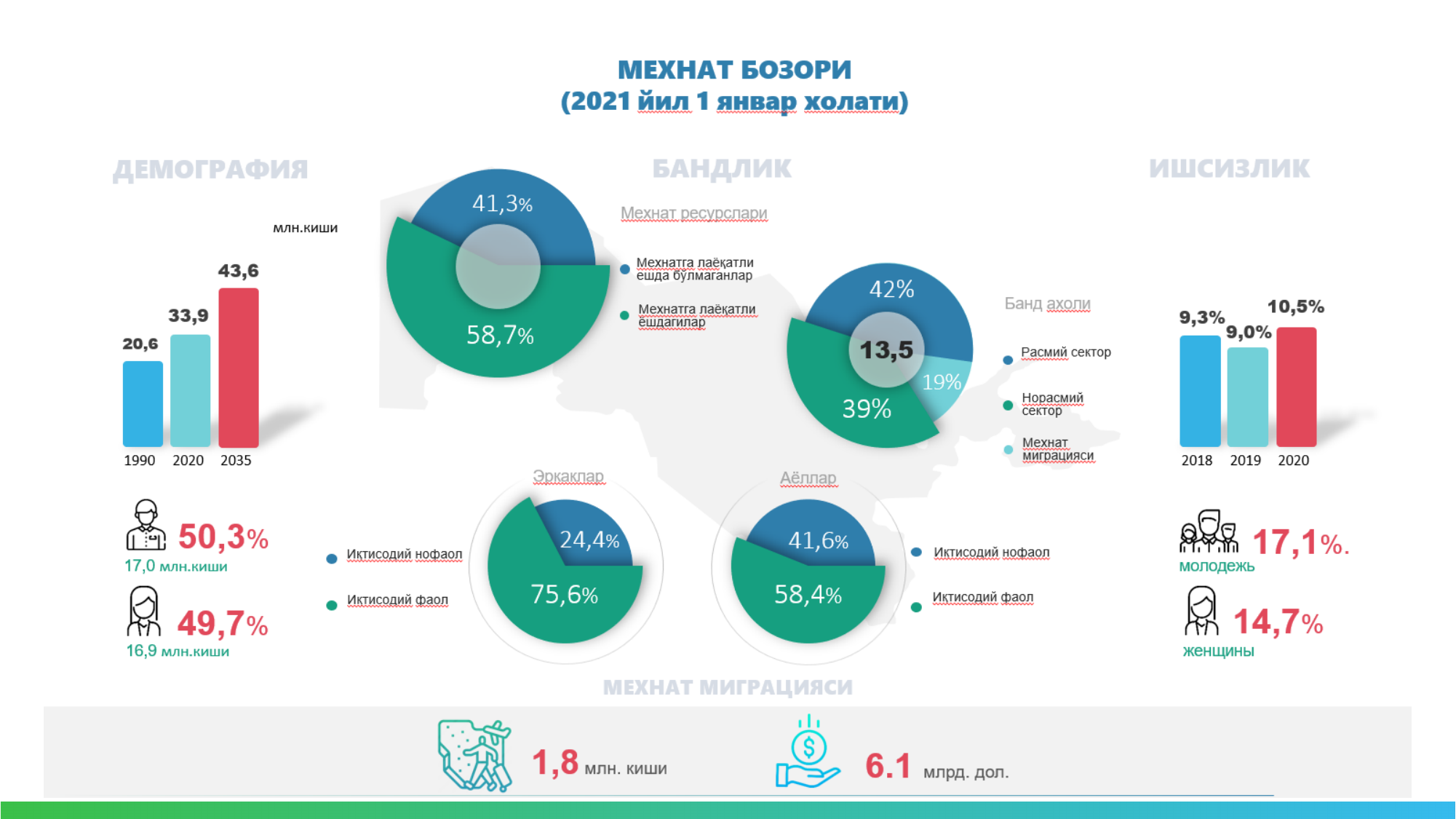
In the pie chart titled Мехнат ресурслари, what share is labelled Мехнатга лаёқатли ёшдагилар? 58,7% In the pie chart titled Аёллар, which slice is larger, Иқтисодий фаол or Иқтисодий нофаол? Иқтисодий фаол In the pie chart titled Банд ахоли, what share is labelled Мехнат миграцияси? 19% In the bar chart under ИШСИЗЛИК on the right, which year has the highest value? 2020 In the bar chart under ИШСИЗЛИК on the right, is the value for 2018 larger or smaller than the value for 2019? larger In the bar chart under ДЕМОГРАФИЯ on the left, which year has the lowest value? 1990 In the bar chart under ДЕМОГРАФИЯ on the left, what is the value for 2035? 43,6 How many bars are in the bar chart under ДЕМОГРАФИЯ on the left? 3 In the bar chart under ИШСИЗЛИК on the right, what is the value for 2019? 9,0% In the pie chart titled Эркаклар, what share is labelled Иқтисодий нофаол? 24,4% In the bar chart under ДЕМОГРАФИЯ on the left, what is the difference between the 2020 and 1990 values? 13,3 How many entries does the legend of the pie chart titled Банд ахоли list? 3